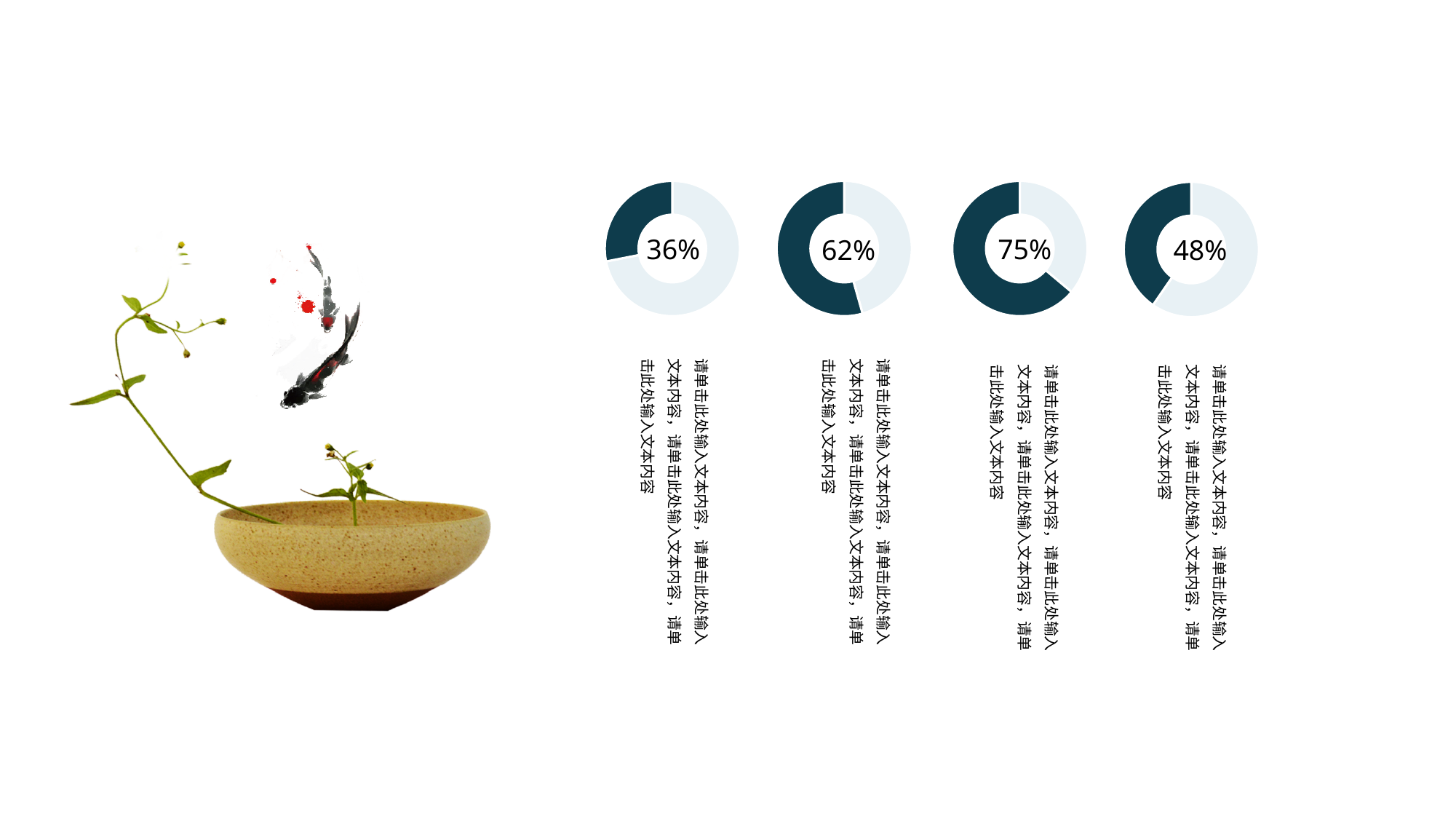
What is the difference between the percentage in the third donut chart and the percentage in the leftmost donut chart? 39% What percentage is shown in the center of the second donut chart from the left? 62% How many donut charts are on the slide? 4 Which of the four donut charts shows the highest percentage? The third from the left (75%) What kind of chart is used to display the four percentages on the slide? Donut chart What colour is the filled portion of each donut chart? Dark teal blue Which is larger: the percentage in the second donut chart from the left or the percentage in the rightmost donut chart? The second from the left (62%) What percentage is shown in the center of the leftmost donut chart? 36% What is the difference between the percentages shown in the second and fourth donut charts from the left? 14% What percentage is shown in the center of the rightmost donut chart? 48% Which of the four donut charts shows the lowest percentage? The leftmost (36%) What percentage is shown in the center of the third donut chart from the left? 75%